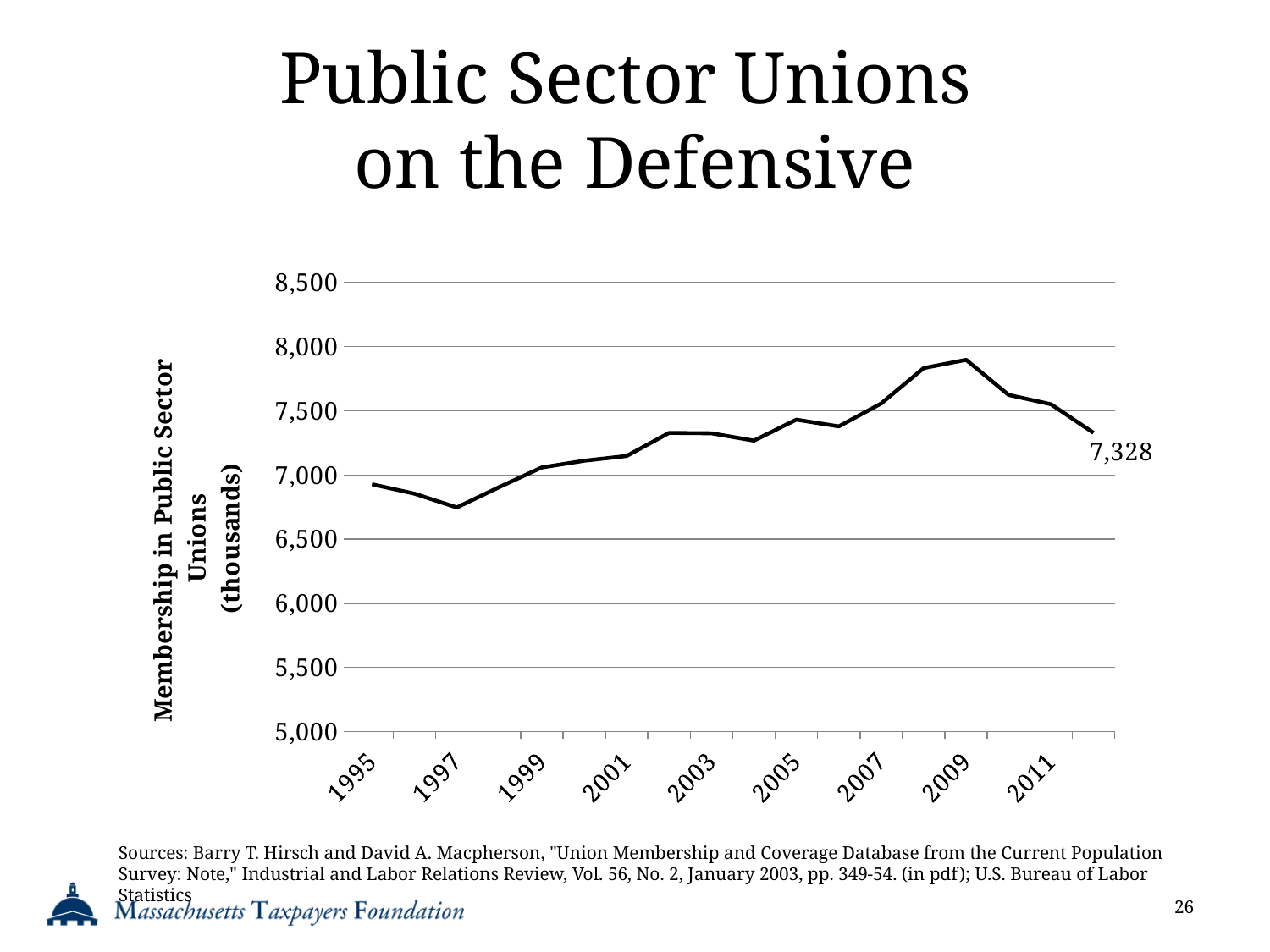
In which labeled year is public sector union membership at its lowest? 1997 Does membership rise or fall between 1997 and 2009? rise Is the value for 2009 greater or less than 7,500? greater What value is printed as the data label at the end of the line? 7,328 Is the value for 2001 greater or less than 7,500? less Which year has the higher membership, 2005 or 1999? 2005 Is the value for 1995 greater or less than 7,000? less Which year has the higher membership, 1997 or 2009? 2009 In which labeled year does public sector union membership reach its highest point? 2009 What is the title of the y axis? Membership in Public Sector Unions (thousands) How many year labels are shown on the x axis? 9 What kind of chart is shown on the slide? line chart